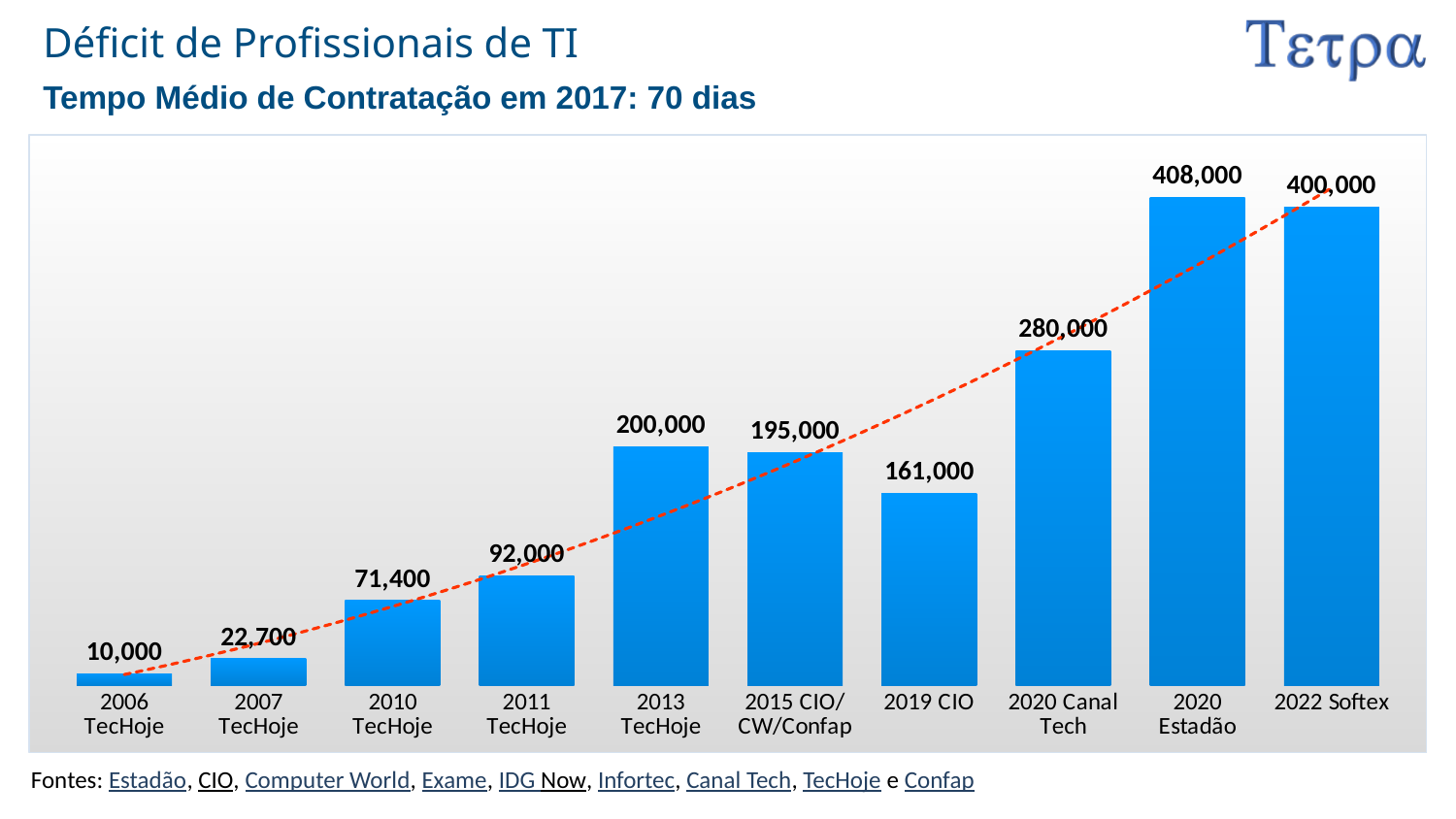
What is the value for 2013 TecHoje? 200,000 Which is larger, the value for 2013 TecHoje or the value for 2015 CIO/CW/Confap? 2013 TecHoje What is the subtitle shown above the chart? Tempo Médio de Contratação em 2017: 70 dias What is the difference between the values for 2020 Estadão and 2022 Softex? 8,000 Which category has the lowest value? 2006 TecHoje Do the values generally rise or fall from left to right along the x axis? Rise What kind of chart is shown on the slide? Bar chart What is the value for 2010 TecHoje? 71,400 Which category has the highest value? 2020 Estadão What is the value for 2019 CIO? 161,000 How many bars are shown in the chart? 10 What is the difference between the values for 2011 TecHoje and 2007 TecHoje? 69,300